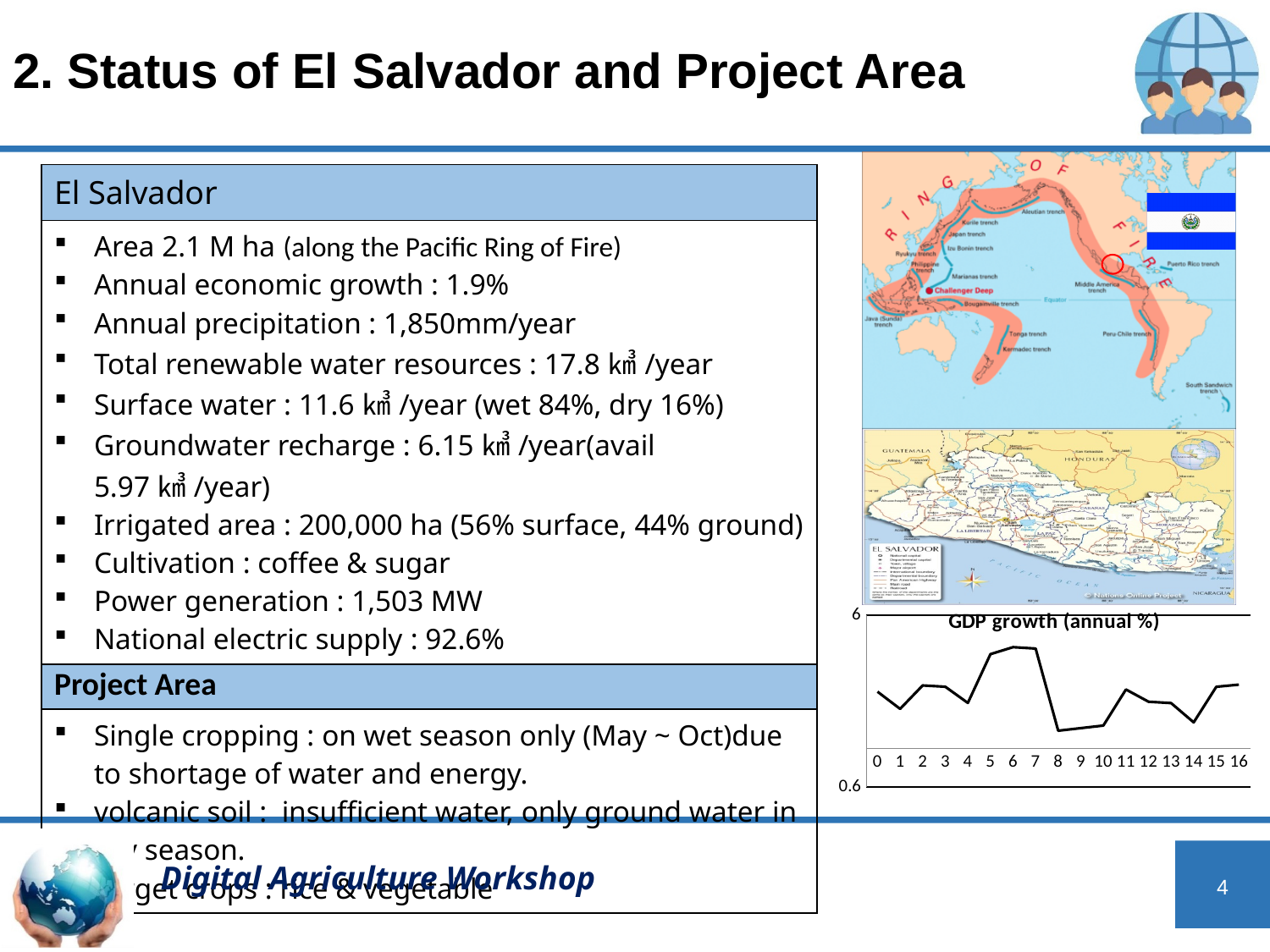
On the GDP growth (annual %) chart, does the line rise or fall between x = 4 and x = 6? rise What is the highest value labelled on the y axis of the GDP growth (annual %) chart? 6 On the GDP growth (annual %) chart, is the value at x = 6 greater or less than 6? less What is the title of the chart on the slide? GDP growth (annual %) On the GDP growth (annual %) chart, which is larger, the value at x = 14 or the value at x = 15? x = 15 On the GDP growth (annual %) chart, does the line rise or fall between x = 7 and x = 8? fall On the GDP growth (annual %) chart, which is larger, the value at x = 6 or the value at x = 8? x = 6 On the GDP growth (annual %) chart, does the line rise or fall between x = 0 and x = 1? fall On the GDP growth (annual %) chart, which is larger, the value at x = 1 or the value at x = 2? x = 2 How many data points are plotted on the GDP growth (annual %) chart? 17 How many lines are plotted on the GDP growth (annual %) chart? 1 What kind of chart is the GDP growth (annual %) chart on the slide? line chart